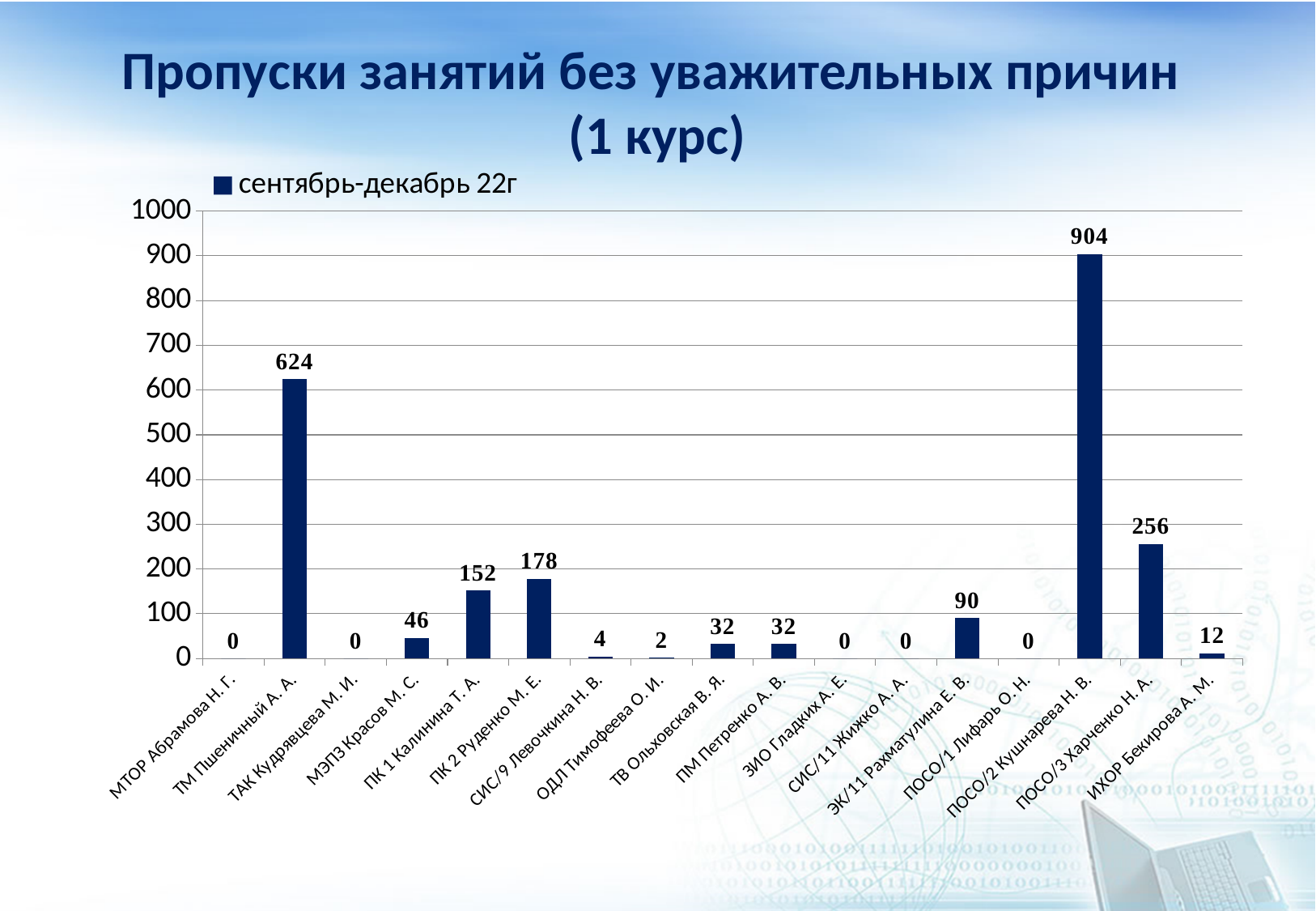
What kind of chart is shown on the slide? bar chart What value is shown for ЭК/11 Рахматулина Е. В.? 90 Which category has the highest value? ПОСО/2 Кушнарева Н. В. What value is shown for ПОСО/2 Кушнарева Н. В.? 904 How many categories are shown on the x axis? 17 What value is shown for ТМ Пшеничный А. А.? 624 Which is larger, the value for ПОСО/3 Харченко Н. А. or the value for ПК 2 Руденко М. Е.? ПОСО/3 Харченко Н. А. What series does the legend list? сентябрь-декабрь 22г What value is shown for ИХОР Бекирова А. М.? 12 Is the value for ТМ Пшеничный А. А. greater or less than 500? greater What is the difference between the values for ПК 2 Руденко М. Е. and ПК 1 Калинина Т. А.? 26 What is the difference between the values for ПОСО/2 Кушнарева Н. В. and ТМ Пшеничный А. А.? 280